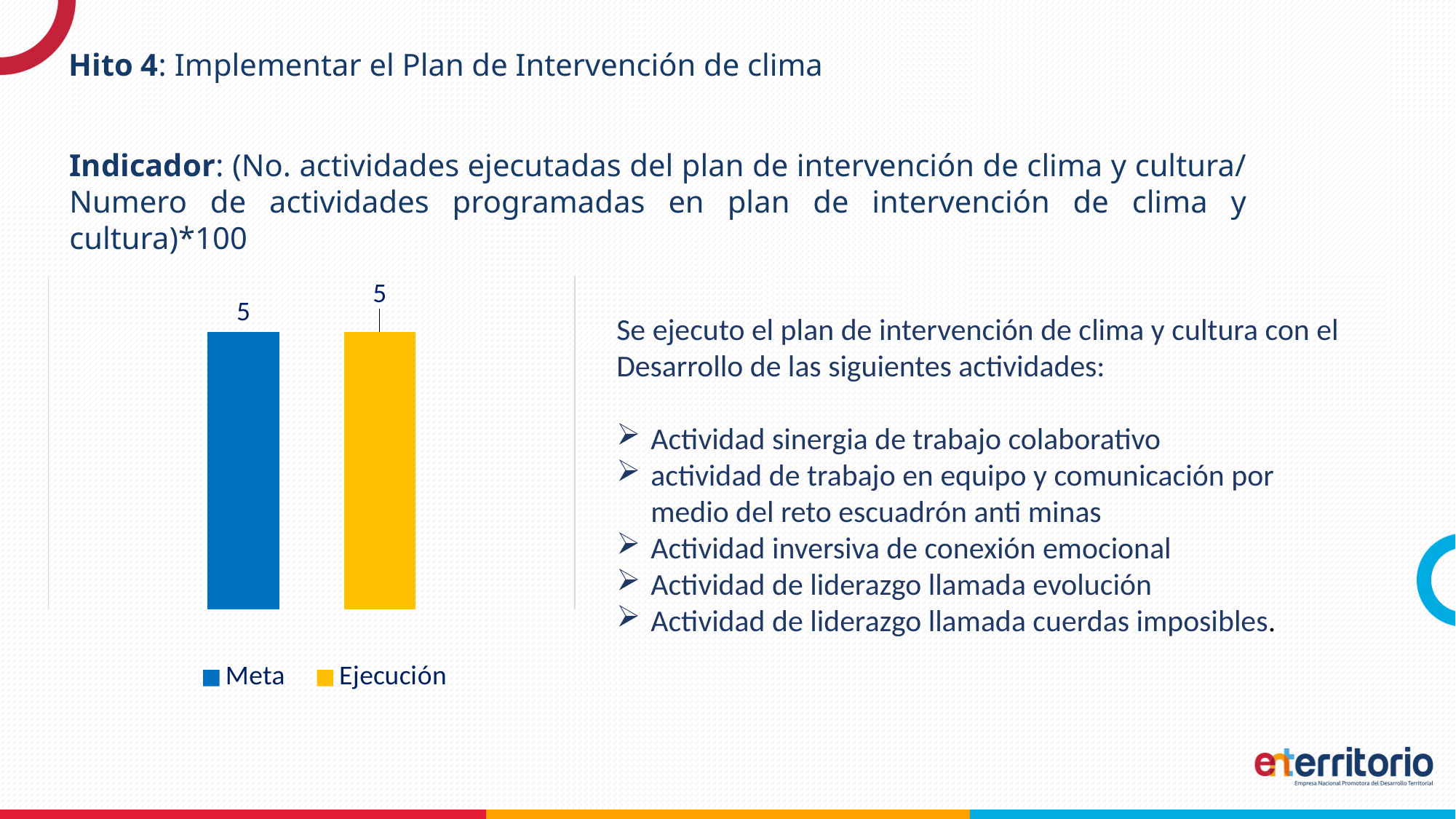
Which legend entry is shown in yellow? Ejecución What is the value of the Meta bar? 5 What is the total of the Meta and Ejecución values? 10 Are the Meta and Ejecución values equal? Yes What is the difference between the Meta and Ejecución values? 0 What kind of chart is shown on the slide? bar chart How many series does the legend list? 2 How many bars are plotted in the chart? 2 Which legend entry is shown in blue? Meta What is the value of the Ejecución bar? 5